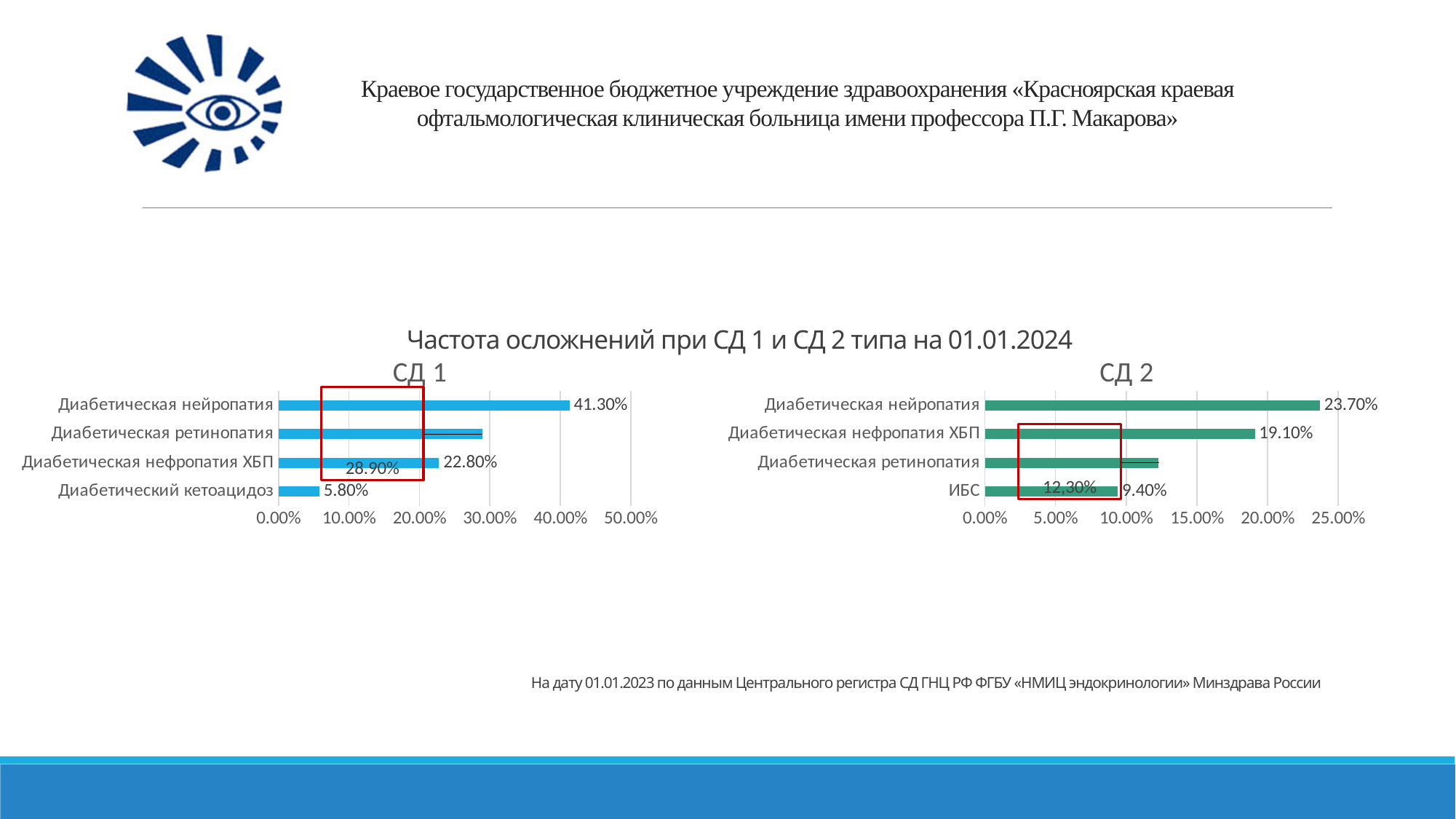
In the СД 1 chart, is the value for Диабетическая ретинопатия greater or less than 20.00%? greater In the СД 2 chart, what is the value for Диабетическая нефропатия ХБП? 19.10% In the СД 2 chart, which category has the highest value? Диабетическая нейропатия In the СД 1 chart, what is the value for Диабетический кетоацидоз? 5.80% In the СД 2 chart, which is larger: Диабетическая нефропатия ХБП or ИБС? Диабетическая нефропатия ХБП What kind of chart is the СД 1 chart? bar chart In the СД 1 chart, what is the difference between Диабетическая нейропатия and Диабетическая нефропатия ХБП? 18.50% In the СД 1 chart, what is the value for Диабетическая нефропатия ХБП? 22.80% In the СД 2 chart, what is the value for ИБС? 9.40% In the СД 1 chart, which category has the lowest value? Диабетический кетоацидоз In the СД 1 chart, what is the value for Диабетическая нейропатия? 41.30% How many categories are shown in the СД 2 chart? 4